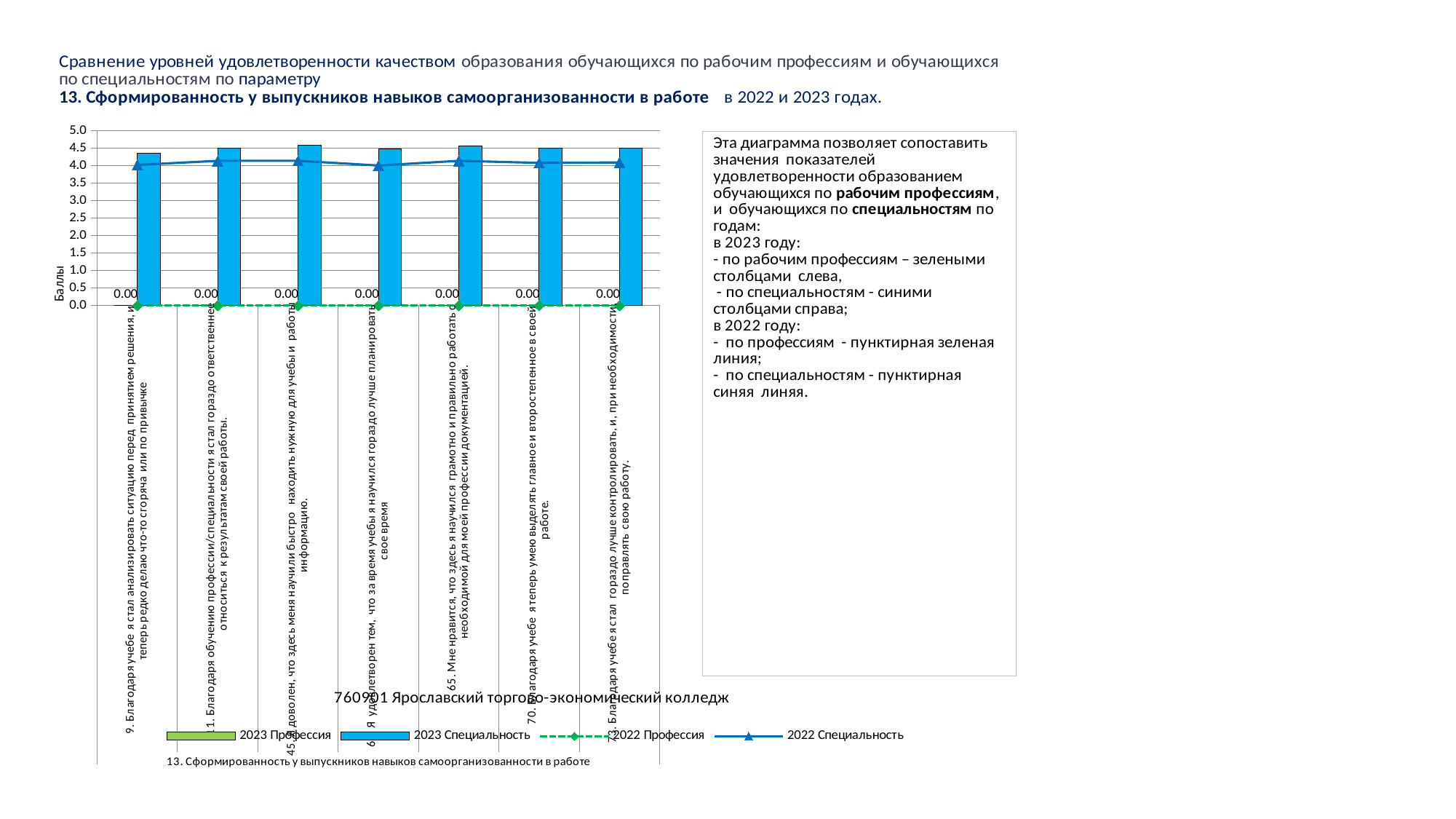
How many series does the chart legend list? 4 For statement 9, which is larger: the 2023 Специальность bar or the 2022 Специальность line value? 2023 Специальность What is the value of the 2023 Профессия series for statement 65 ("Мне нравится, что здесь я научился грамотно и правильно работать...")? 0.00 Is the 2023 Специальность value for statement 9 greater or less than 4.0? greater How does the 2022 Профессия line change across the categories along the x axis? it stays flat at 0.00 What is the value of the 2023 Профессия series for statement 9 ("Благодаря учебе я стал анализировать ситуацию...")? 0.00 Which is larger for the 2023 Специальность series: the bar for statement 9 or the bar for statement 11? statement 11 What kind of chart is shown on the slide? bar chart with line series Is the 2023 Специальность value for statement 45 greater or less than 3.0? greater How many categories (survey statements) are shown along the x axis of the chart? 7 What is the label of the vertical axis of the chart? Баллы